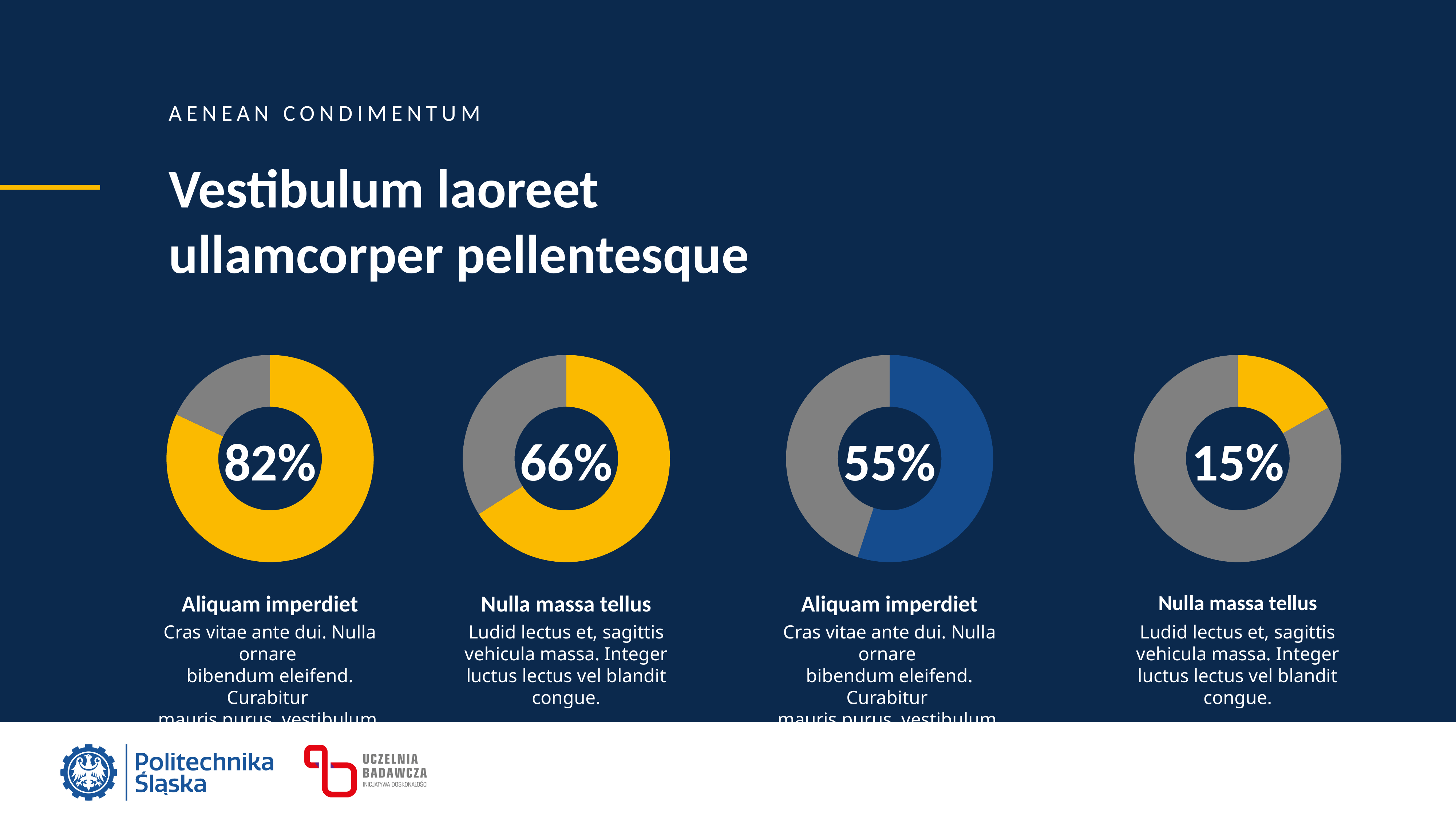
What is the difference between the percentages shown in the second and third donut charts from the left? 11% What value is shown in the centre of the leftmost donut chart? 82% What value is shown in the centre of the third donut chart from the left? 55% Which of the four donut charts shows the highest percentage? The leftmost chart (82%) What value is shown in the centre of the second donut chart from the left? 66% How many donut charts are shown on the slide? 4 What kind of chart is used to display the percentages on the slide? Donut chart What value is shown in the centre of the rightmost donut chart? 15% What colour is the filled portion of the third donut chart from the left (55%)? Blue What is the difference between the percentage in the leftmost donut chart and the percentage in the rightmost donut chart? 67% Which is larger: the percentage in the second donut chart from the left or the percentage in the third donut chart from the left? The second chart from the left (66%) Which of the four donut charts shows the lowest percentage? The rightmost chart (15%)